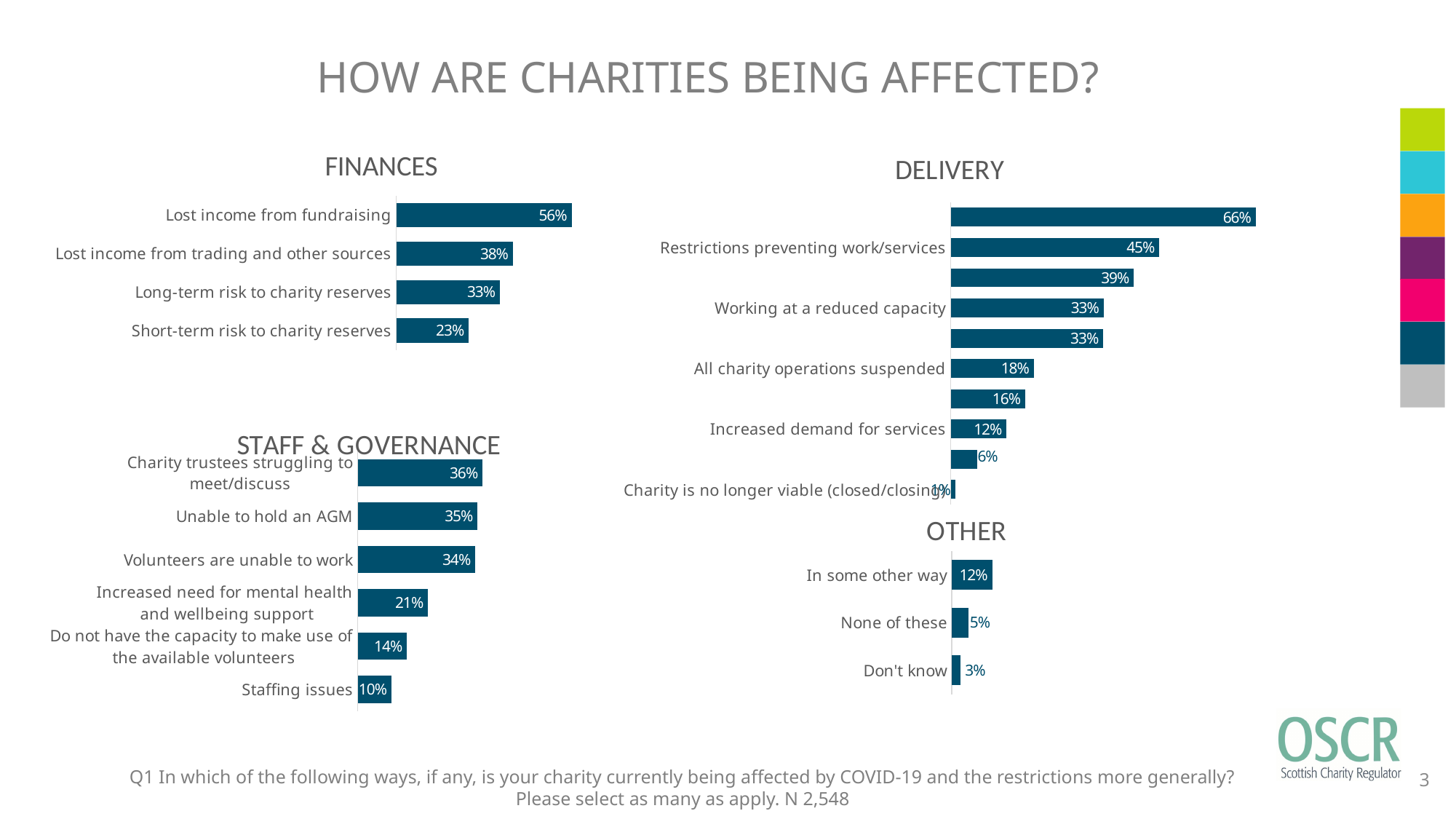
In the STAFF & GOVERNANCE chart, what is the value for Staffing issues? 10% In the FINANCES chart, which category has the lowest value? Short-term risk to charity reserves In the OTHER chart, what is the value for None of these? 5% How many categories are shown in the FINANCES chart? 4 In the DELIVERY chart, what is the value for All charity operations suspended? 18% In the DELIVERY chart, what is the value for Restrictions preventing work/services? 45% In the DELIVERY chart, which is larger: Working at a reduced capacity or Increased demand for services? Working at a reduced capacity In the STAFF & GOVERNANCE chart, what is the value for Volunteers are unable to work? 34% In the FINANCES chart, what is the value for Lost income from fundraising? 56% What type of chart is the OTHER chart? Bar chart In the FINANCES chart, what is the difference between Lost income from fundraising and Lost income from trading and other sources? 18% In the STAFF & GOVERNANCE chart, which category has the highest value? Charity trustees struggling to meet/discuss